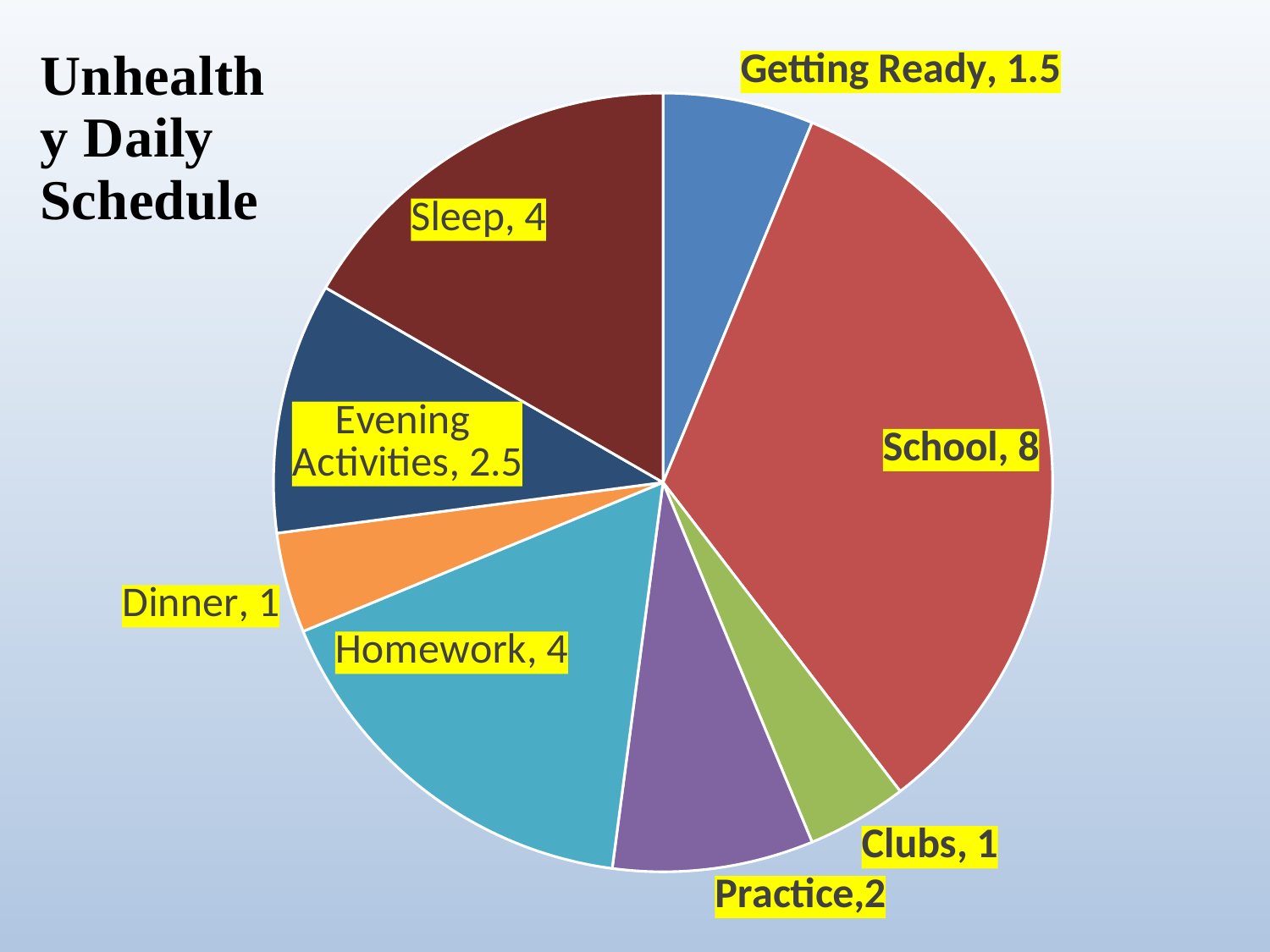
What is the difference between the values for School and Homework? 4 What is the difference between the values for Evening Activities and Dinner? 1.5 Which is larger, the value for Sleep or the value for Practice? Sleep Which category has the largest slice of the pie? School What is the value for Practice? 2 What is the title of the chart? Unhealthy Daily Schedule What is the value for School? 8 What is the total of all the slice values in the pie chart? 24 What is the value for Getting Ready? 1.5 How many slices does the pie chart have? 8 What is the value for Evening Activities? 2.5 What kind of chart is shown on the slide? pie chart